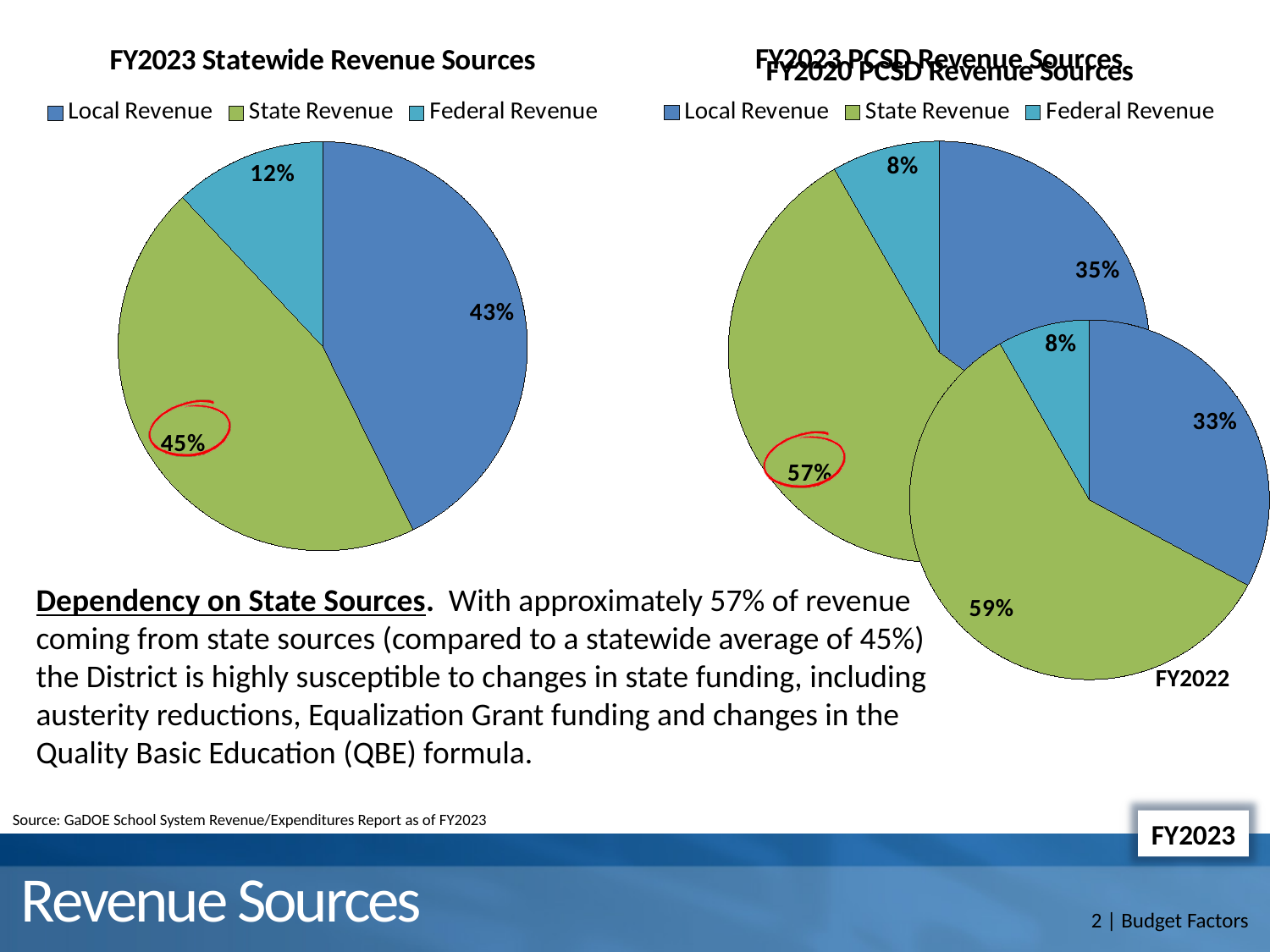
In the FY2023 Statewide Revenue Sources pie chart, what share is Federal Revenue? 12% In the FY2023 Statewide Revenue Sources pie chart, what share is State Revenue? 45% In the FY2023 Statewide Revenue Sources pie chart, what is the difference between the State Revenue and Local Revenue shares? 2% In the larger PCSD Revenue Sources pie chart at the top right, what share is Local Revenue? 35% In the larger PCSD Revenue Sources pie chart at the top right, what share is State Revenue? 57% In the small pie chart labeled FY2022 at the bottom right, what share is Local Revenue? 33% In the small pie chart labeled FY2022 at the bottom right, what share is State Revenue? 59% How many entries does the legend of the FY2023 Statewide Revenue Sources chart list? 3 What type of chart is the FY2023 Statewide Revenue Sources chart? Pie chart In the larger PCSD Revenue Sources pie chart at the top right, which revenue source has the largest share? State Revenue In the FY2023 Statewide Revenue Sources pie chart, which revenue source has the smallest share? Federal Revenue In the FY2023 Statewide Revenue Sources pie chart, what share is Local Revenue? 43%